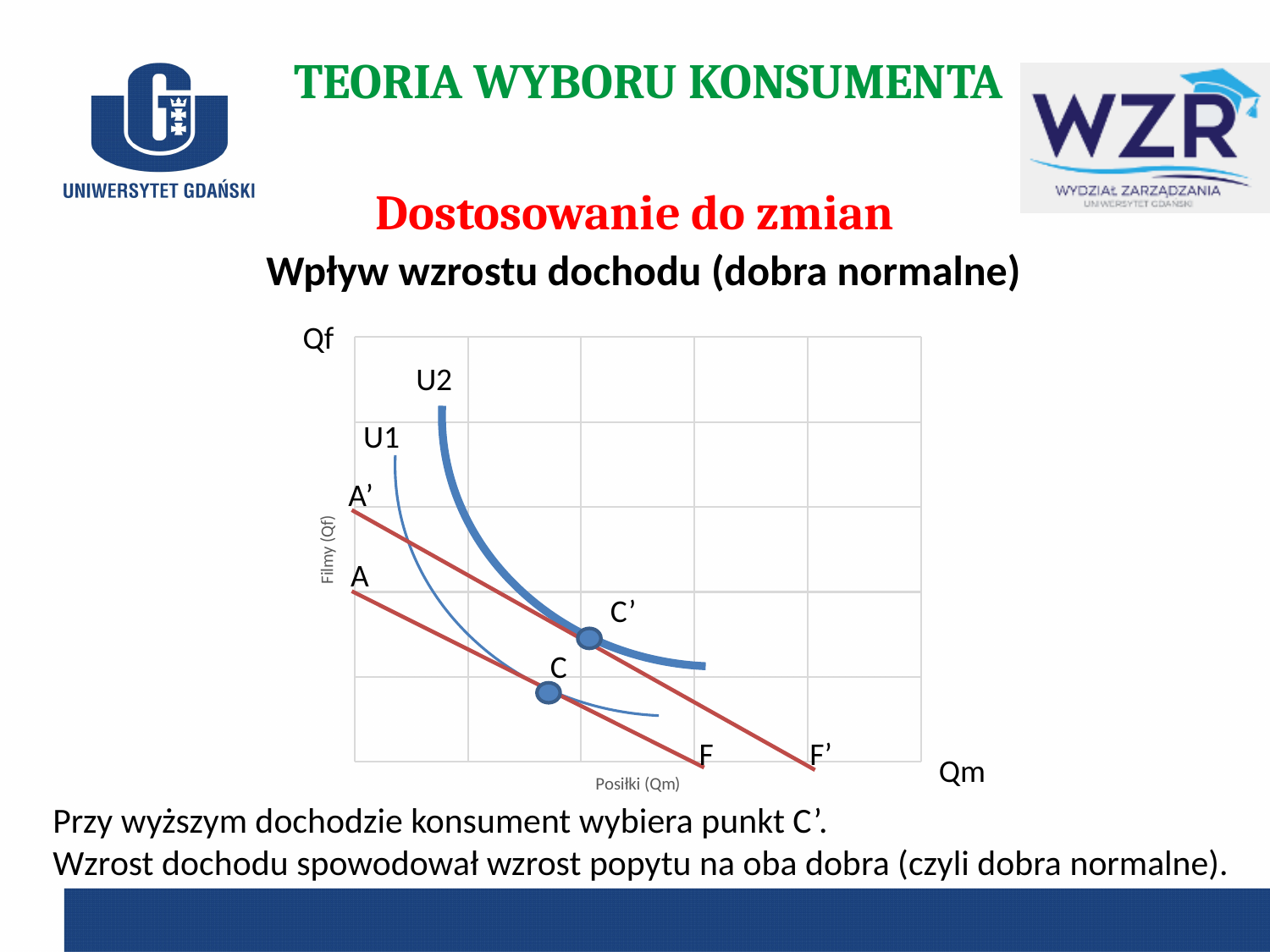
How many indifference curves (U curves) are drawn on the chart? 2 Is point C' to the right or to the left of point C along the Qm axis? right Which labelled point lies on the indifference curve U1? C Do the indifference curves rise or fall as Qm increases? fall Which indifference curve lies farther from the origin, U1 or U2? U2 How many budget lines (red lines) are drawn on the chart? 2 What is the label of the vertical axis of the chart? Filmy (Qf) Which budget line meets the Qm axis farther to the right, AF or A'F'? A'F' What kind of chart is shown on the slide? line chart Which labelled point lies on the indifference curve U2? C' What is the label of the horizontal axis of the chart? Posiłki (Qm)